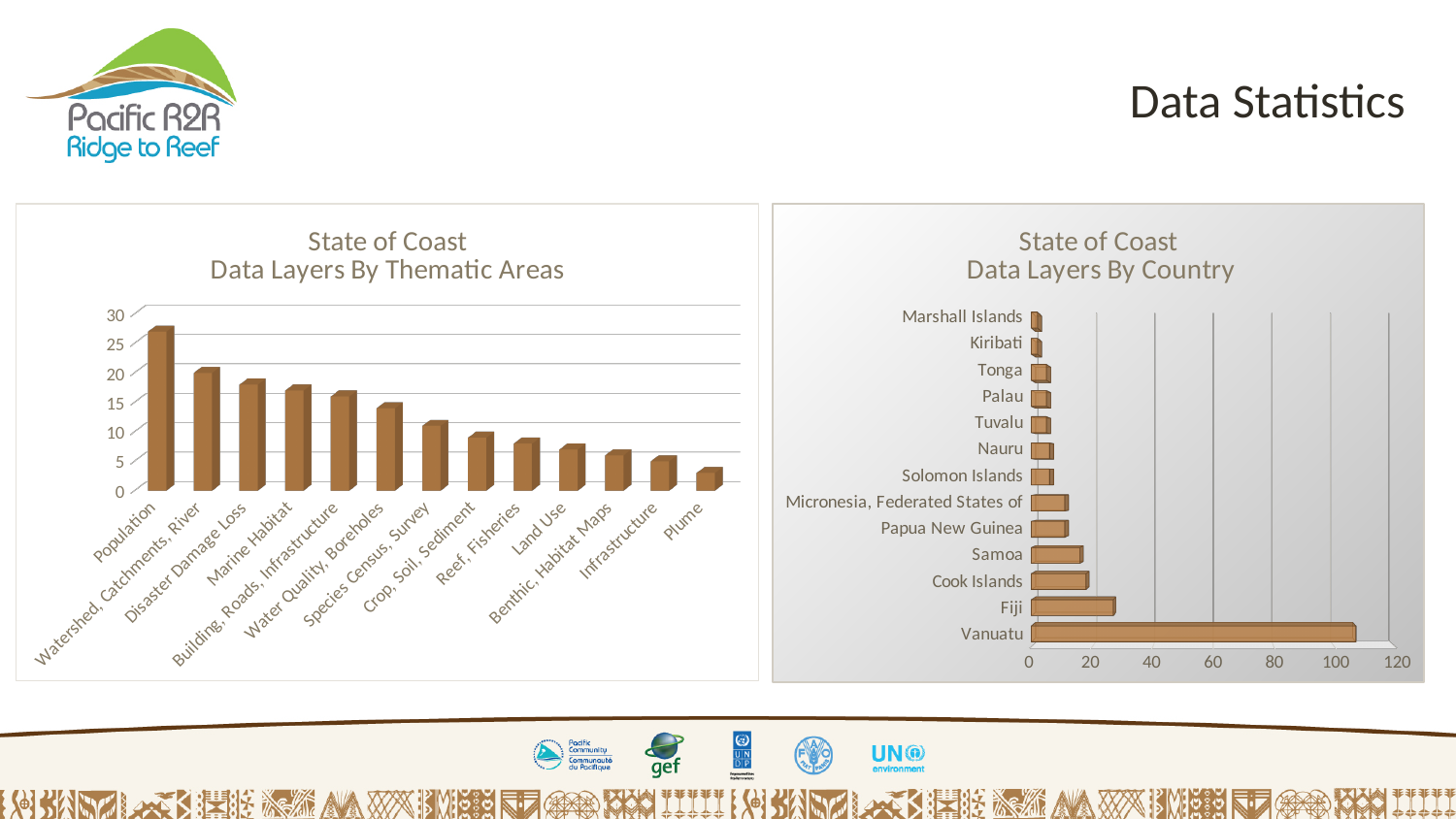
In the 'Data Layers By Thematic Areas' chart, which thematic area has the lowest value? Plume How many countries are shown in the 'Data Layers By Country' chart? 13 What kind of chart is the 'State of Coast Data Layers By Country' chart? bar chart In the 'Data Layers By Country' chart, is the value for Vanuatu greater or less than 100? greater In the 'Data Layers By Thematic Areas' chart, is the value for Plume greater or less than 5? less In the 'Data Layers By Thematic Areas' chart, which is larger: Marine Habitat or Land Use? Marine Habitat What kind of chart is the 'State of Coast Data Layers By Thematic Areas' chart? bar chart In the 'Data Layers By Thematic Areas' chart, is the value for Population greater or less than 20? greater How many thematic areas are shown in the 'Data Layers By Thematic Areas' chart? 13 In the 'Data Layers By Country' chart, which country has the highest value? Vanuatu In the 'Data Layers By Thematic Areas' chart, which thematic area has the highest value? Population